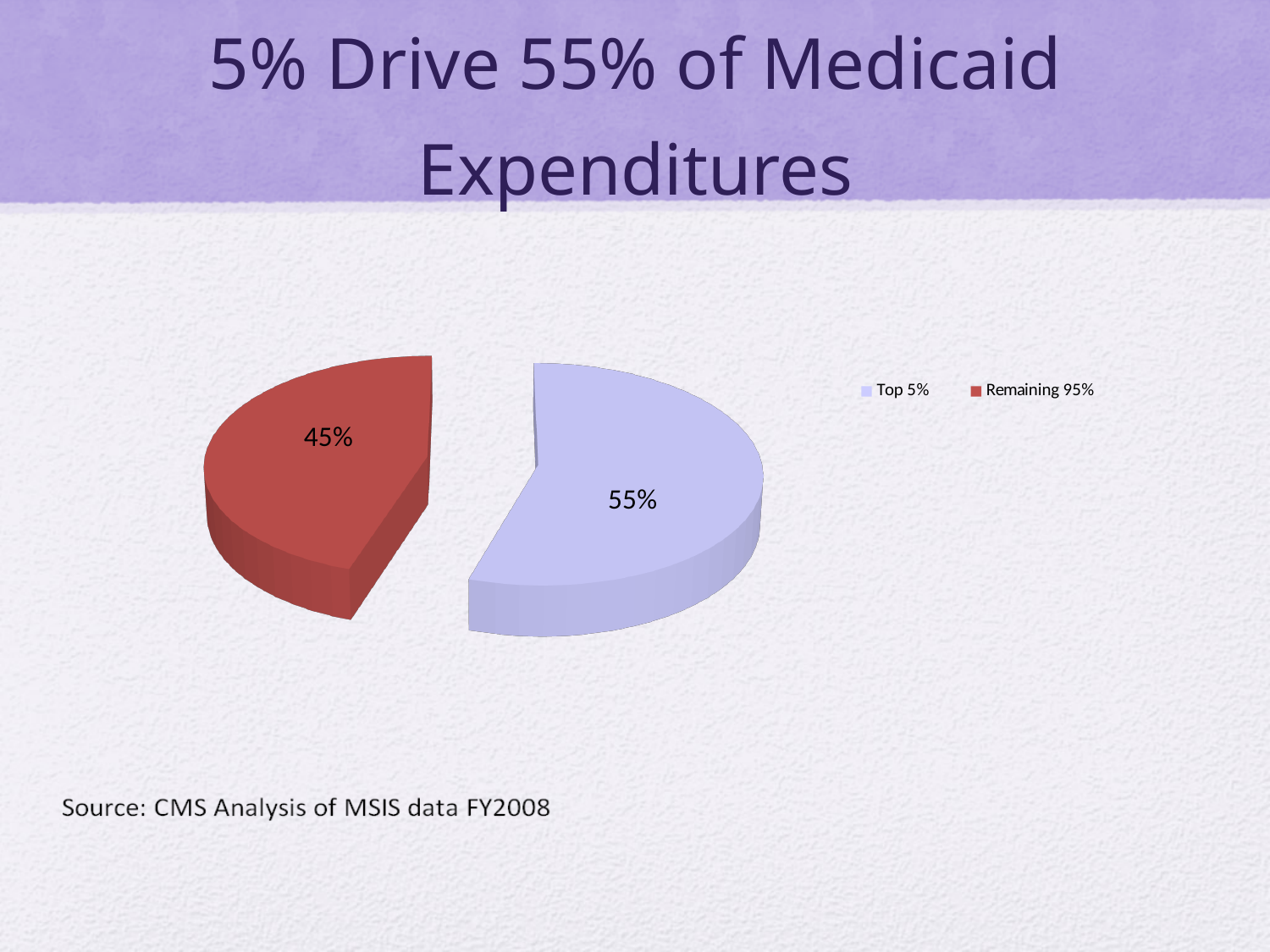
What colour is the Remaining 95% slice? Red Which is larger, the Top 5% slice or the Remaining 95% slice? Top 5% Which slice is the largest in the pie chart? Top 5% Which slice is the smallest in the pie chart? Remaining 95% What share of Medicaid expenditures does the Remaining 95% slice represent? 45% What is the difference in percentage points between the Top 5% slice and the Remaining 95% slice? 10 percentage points How many entries does the legend list? 2 What share of Medicaid expenditures does the Top 5% slice represent? 55% How many slices does the pie chart have? 2 What kind of chart is shown on the slide? Pie chart What is the source cited for the chart data? CMS Analysis of MSIS data FY2008